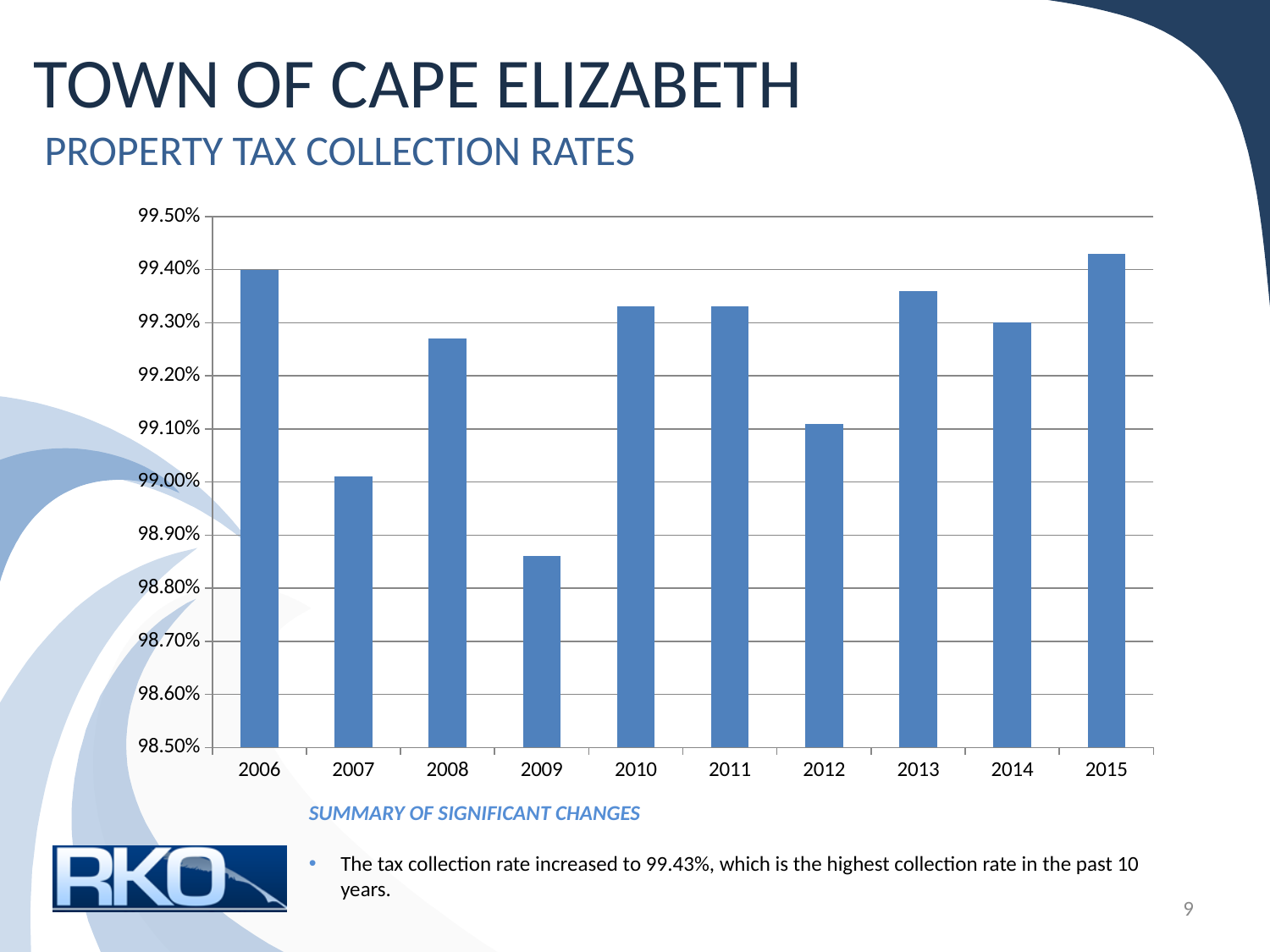
Did the collection rate rise or fall from 2009 to 2010? rise Is the collection rate for 2008 greater or less than 99.30%? less Is the collection rate for 2009 greater or less than 98.90%? less What was the tax collection rate in 2015? 99.43% How many years are shown on the x axis of the chart? 10 Which year has the lowest property tax collection rate? 2009 Which year has a higher collection rate, 2008 or 2013? 2013 What is the subtitle of the chart on the slide? PROPERTY TAX COLLECTION RATES What type of chart is shown on the slide? bar chart Which year has the highest property tax collection rate? 2015 Which year has a higher collection rate, 2007 or 2012? 2012 Is the collection rate for 2012 greater or less than 99.00%? greater